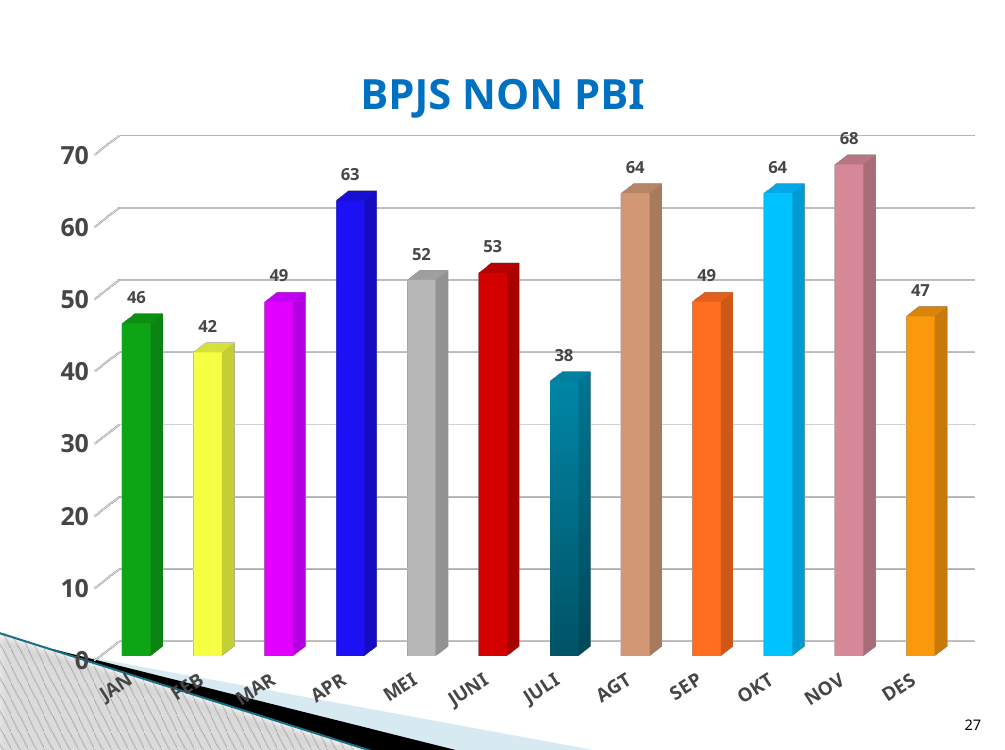
What is the title of the chart? BPJS NON PBI Is the value for AGT greater or less than 60? greater What is the value for APR? 63 What is the difference between the values for NOV and JULI? 30 What kind of chart is this? bar chart What is the value for NOV? 68 How many months are shown on the x axis? 12 Which month has the highest value? NOV Which is larger, the value for JAN or the value for FEB? JAN What is the value for JULI? 38 Which month has the lowest value? JULI